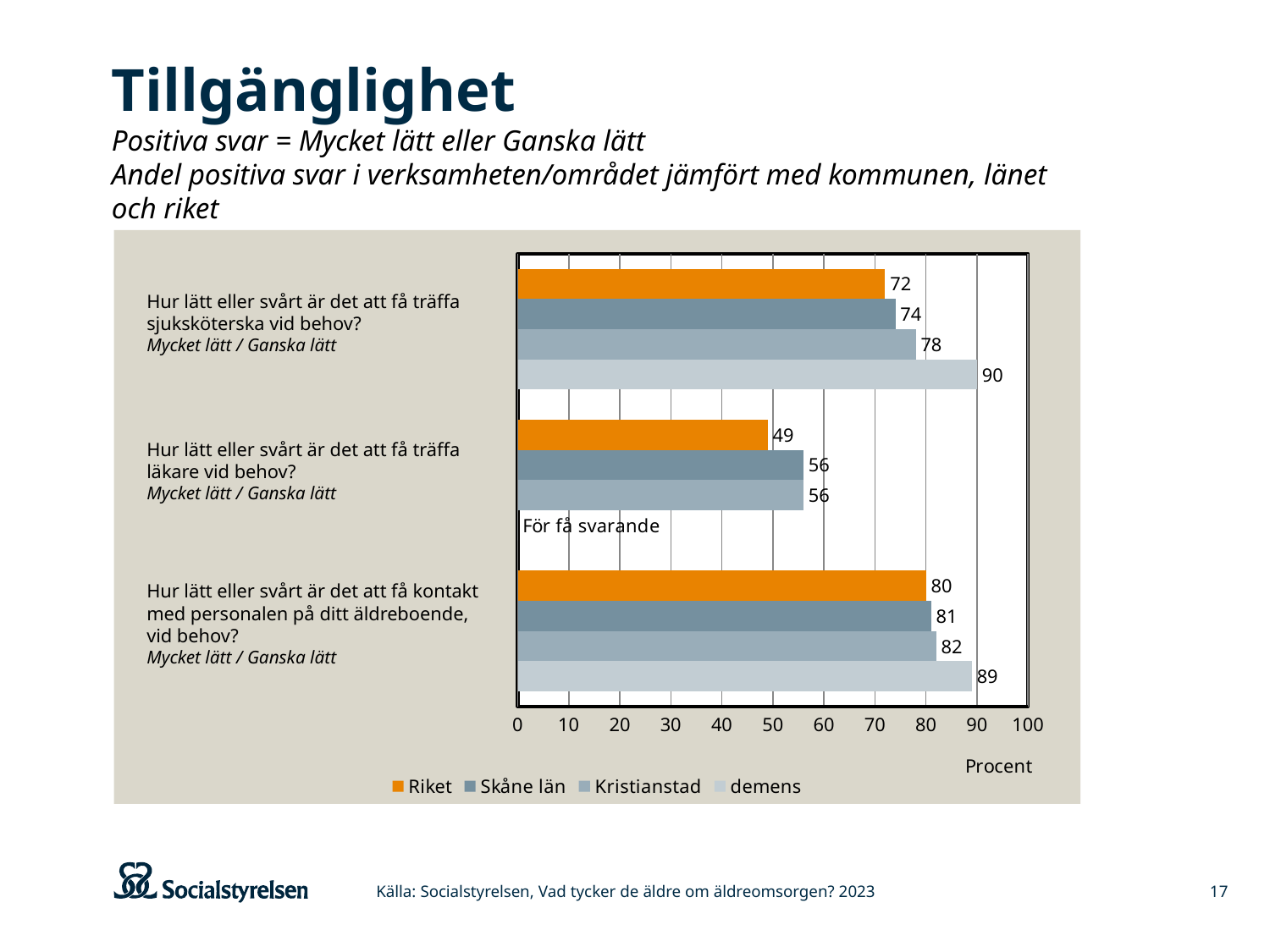
What is the value for Riket for the question about meeting a doctor (läkare) when needed? 49 What kind of chart is shown on the slide? bar chart What is the value for demens for the question about meeting a nurse (sjuksköterska) when needed? 90 How many question categories are shown on the y axis of the chart? 3 Which series has the lowest value for the question about meeting a doctor (läkare)? Riket Which series has the highest value for the question about meeting a nurse (sjuksköterska)? demens What is the difference between the Skåne län value and the Riket value for the question about meeting a doctor (läkare)? 7 What is the value for Kristianstad for the question about getting in contact with staff at the care home (kontakt med personalen)? 82 Which is larger for the question about contact with staff (kontakt med personalen): the value for Riket or the value for demens? demens What is shown instead of a value for demens for the question about meeting a doctor (läkare)? För få svarande How many series does the legend list? 4 What is the difference between the demens value and the Riket value for the question about meeting a nurse (sjuksköterska)? 18